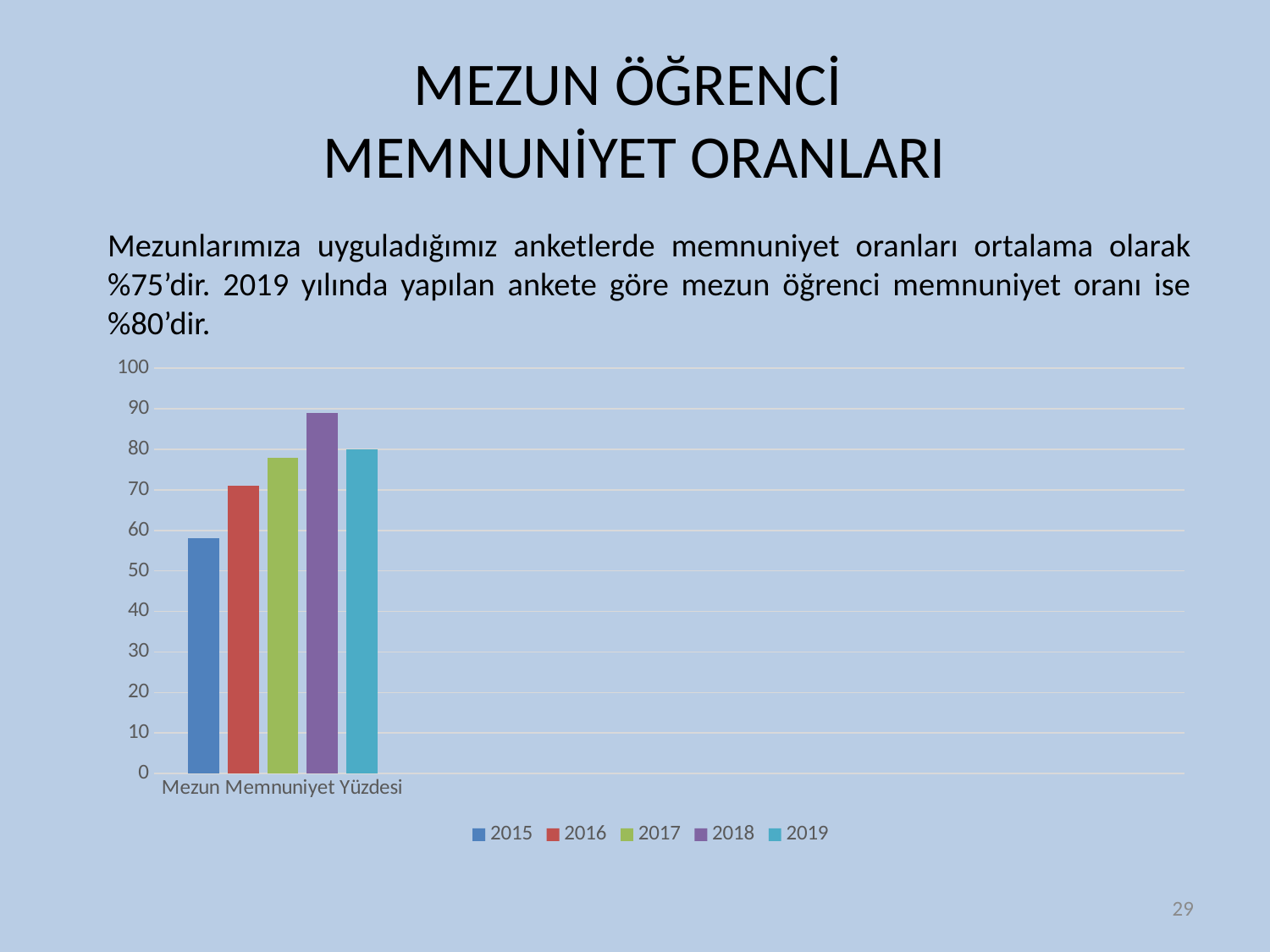
Which year has the highest bar? 2018 What is the category label shown on the x axis? Mezun Memnuniyet Yüzdesi What kind of chart is shown on the slide? bar chart How many categories are shown on the x axis? 1 How many series does the legend list? 5 Is the value for 2015 greater or less than 60? less Which is larger, the value for 2016 or the value for 2017? 2017 Is the value for 2017 greater or less than 80? less Which is larger, the value for 2018 or the value for 2019? 2018 Which year has the lowest bar? 2015 What colour is the bar for 2016? red Is the value for 2018 greater or less than 80? greater